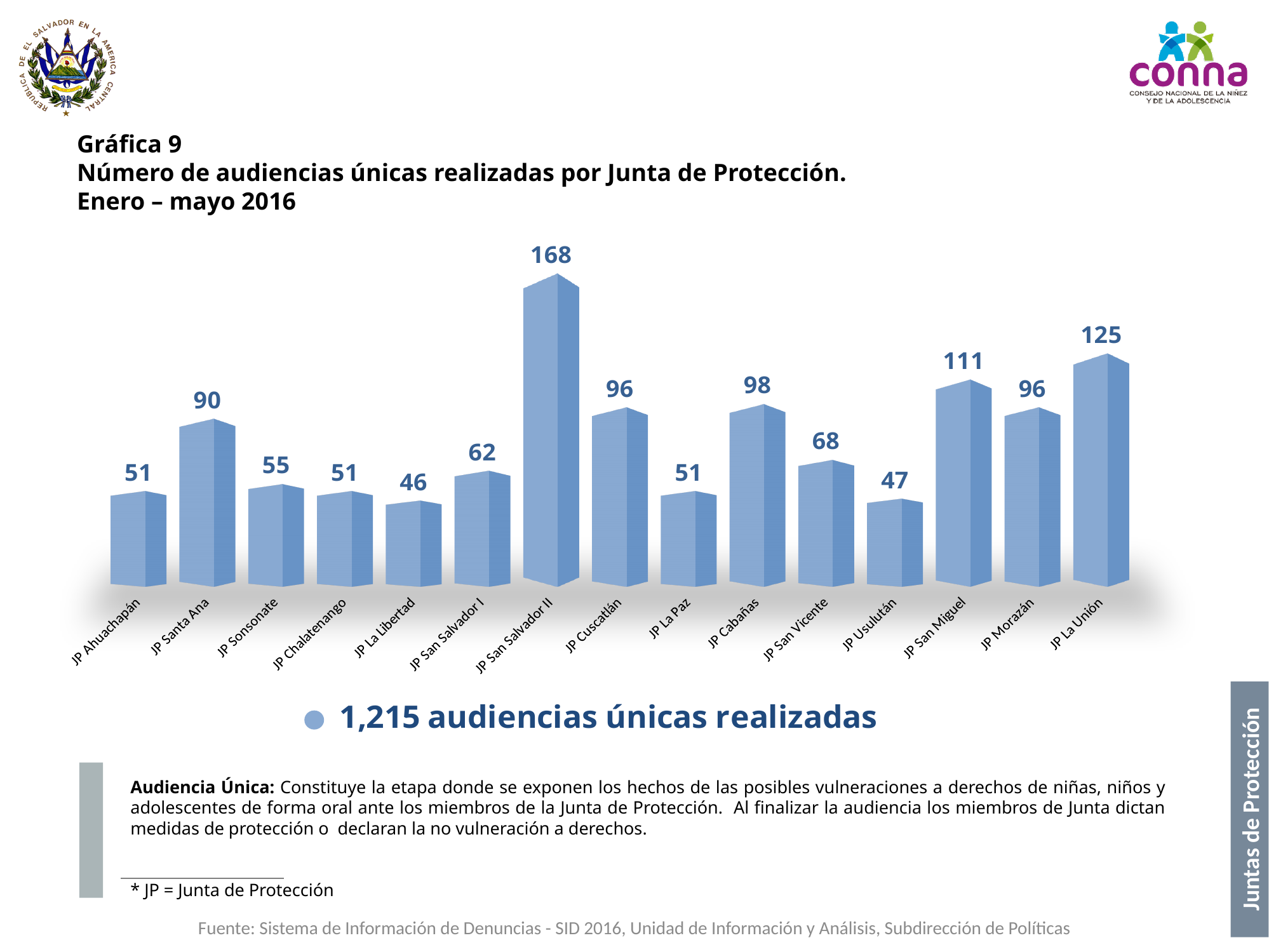
Which is larger, the value for JP San Miguel or the value for JP Morazán? JP San Miguel What is the difference between the values for JP San Salvador II and JP La Unión? 43 How many series does the legend list? 1 How many Juntas de Protección are shown on the chart? 15 What is the value for JP San Salvador II? 168 What is the value for JP La Unión? 125 What is the value for JP Cabañas? 98 What is the difference between the values for JP Santa Ana and JP Sonsonate? 35 Which Junta de Protección has the highest number of audiencias únicas? JP San Salvador II What is the legend entry shown below the chart? 1,215 audiencias únicas realizadas Which Junta de Protección has the lowest number of audiencias únicas? JP La Libertad What kind of chart is shown on the slide? bar chart